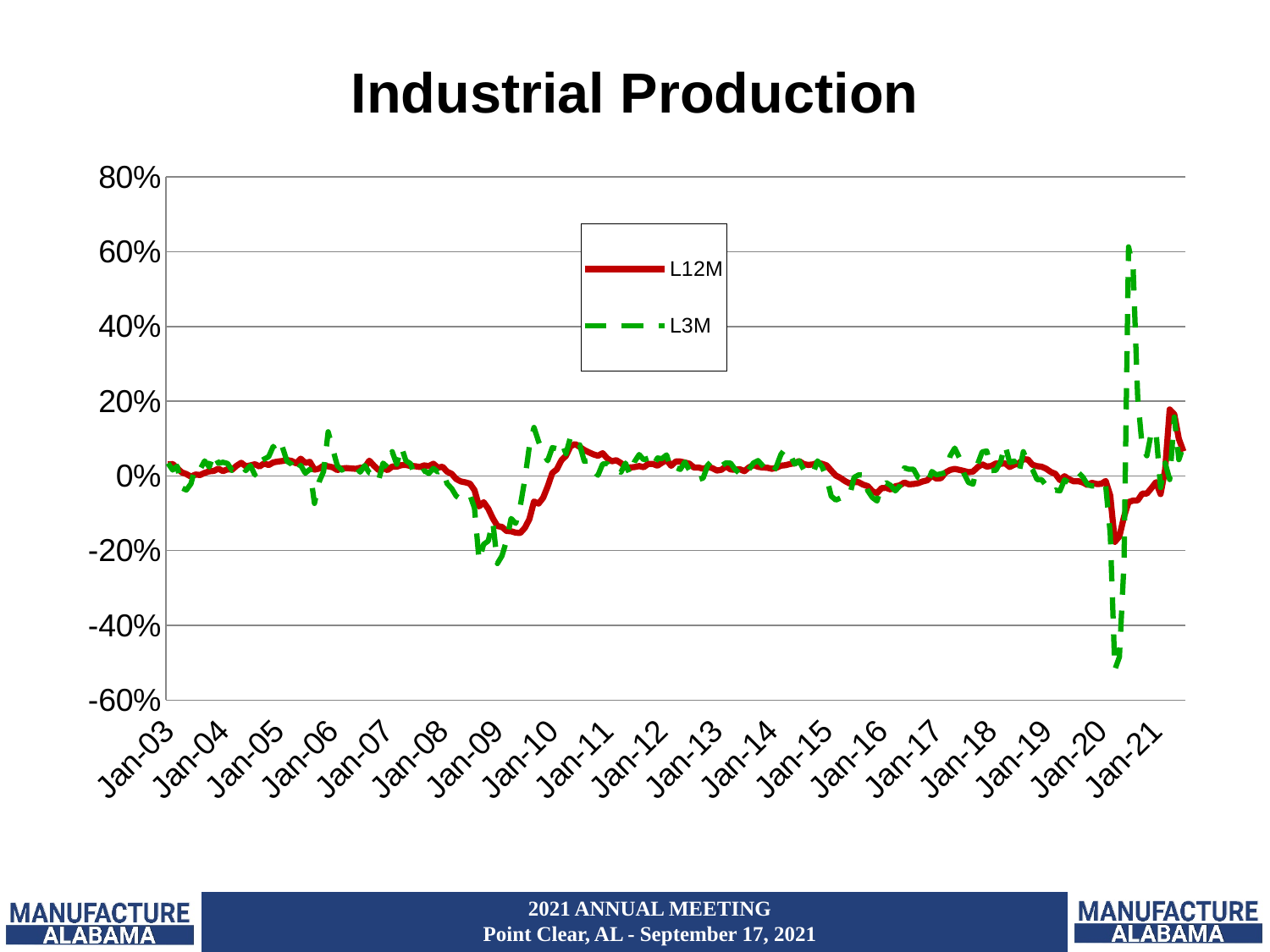
Which series reaches the highest value anywhere on the chart? L3M Is the peak value of L3M around 2020 greater or less than 40%? greater Around 2020, which series reaches a higher peak, L12M or L3M? L3M What kind of chart is shown on the slide? line chart How many series does the legend list? 2 What is the title of the chart? Industrial Production Is the lowest value of L3M around 2020 greater or less than -40%? less Is the lowest value of L12M around 2009 greater or less than 0%? less Between Jan-08 and Jan-09, does the L12M line rise or fall? fall How many year labels are shown on the x axis? 19 Which series reaches the lowest value anywhere on the chart? L3M Which series is drawn as a green dashed line? L3M